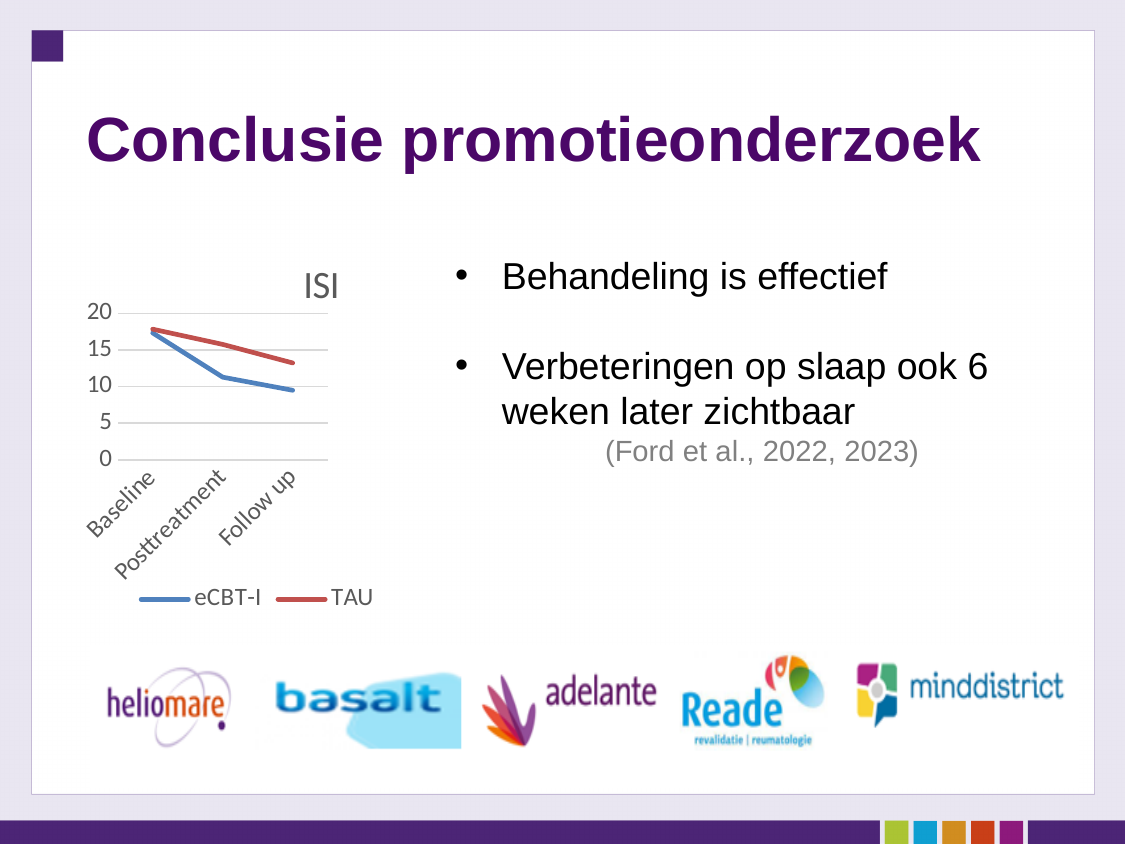
At Follow up, which series has the lower value, eCBT-I or TAU? eCBT-I Do the values for eCBT-I rise or fall from Baseline to Follow up? fall What kind of chart is shown on the slide? line chart How many series does the chart's legend list? 2 How many points are there along the x axis of the chart? 3 What is the title of the chart? ISI Is the value for eCBT-I at Baseline greater or less than 15? greater Which series is drawn in blue in the chart? eCBT-I At Posttreatment, which series has the larger value, eCBT-I or TAU? TAU Do the values for TAU rise or fall from Baseline to Follow up? fall Is the value for TAU at Posttreatment greater or less than 15? greater